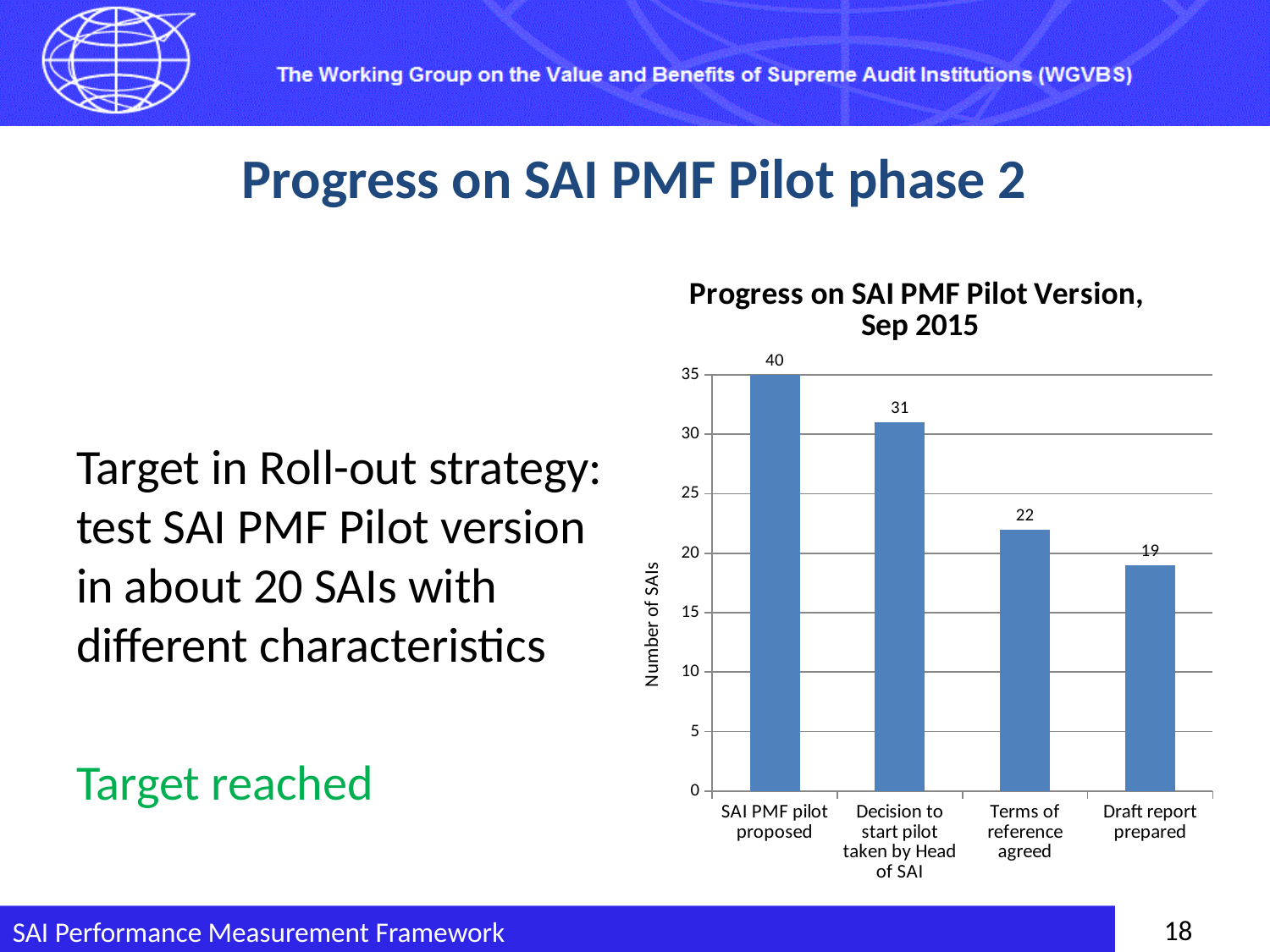
What is the difference between 'Decision to start pilot taken by Head of SAI' and 'Terms of reference agreed'? 9 What is the value for 'Decision to start pilot taken by Head of SAI'? 31 What is the value for 'SAI PMF pilot proposed'? 40 What is the value for 'Draft report prepared'? 19 What kind of chart is shown? Bar chart What is the value for 'Terms of reference agreed'? 22 Which category has the lowest value? Draft report prepared Which category has the highest value? SAI PMF pilot proposed Do the values rise or fall from left to right along the x axis? Fall What is the difference between 'SAI PMF pilot proposed' and 'Draft report prepared'? 21 Which is larger: 'Terms of reference agreed' or 'Draft report prepared'? Terms of reference agreed How many categories are shown on the x axis? 4